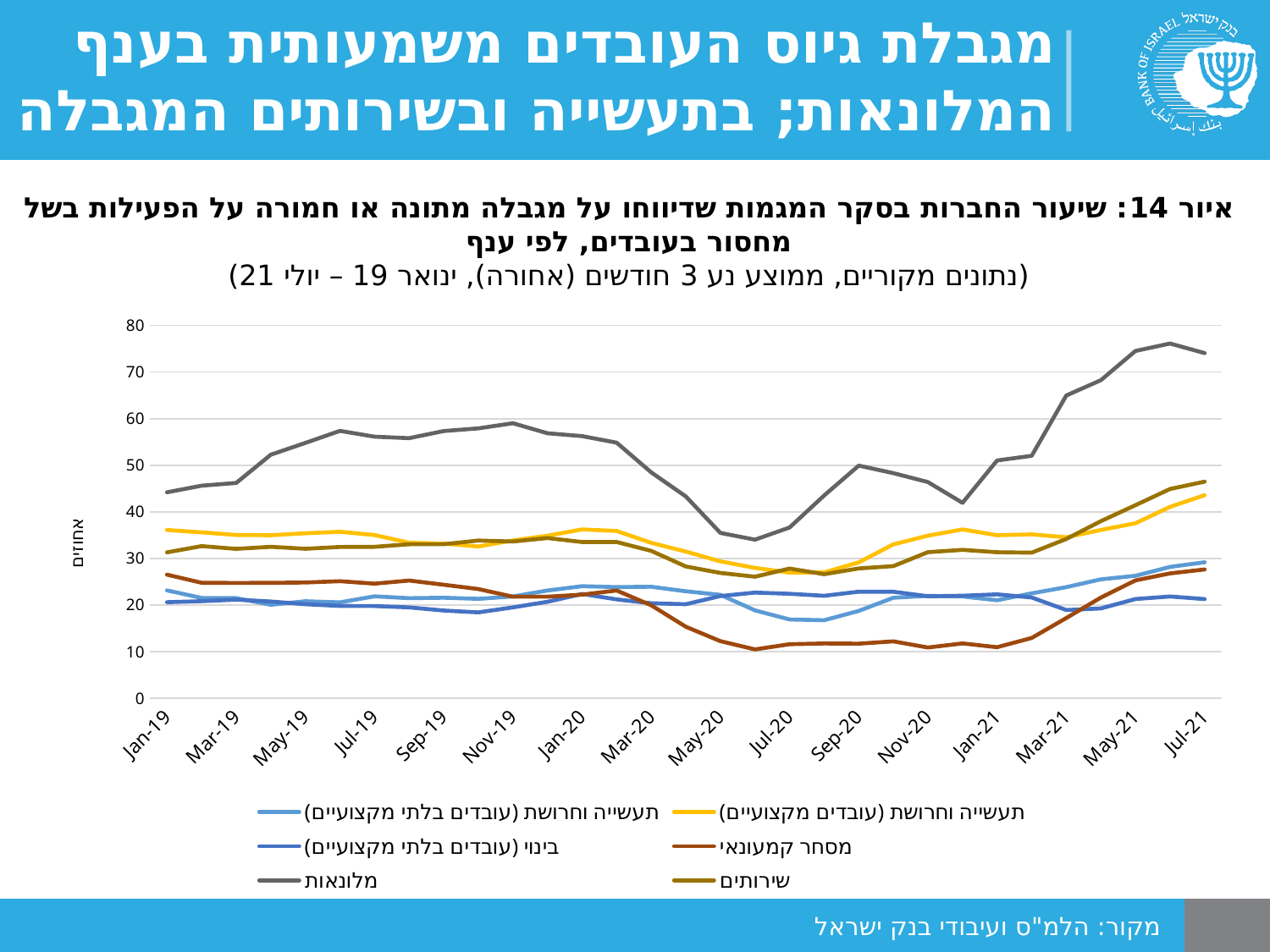
Which series has the lowest value at Jun-20? מסחר קמעונאי What is the label on the vertical axis of the chart? אחוזים What kind of chart is shown on the slide? line chart Is the value for מלונאות at Jun-20 greater or less than 40? less Which series has the highest value at Jan-19? מלונאות Is the value for מלונאות at Jul-21 greater or less than 70? greater Is the value for מסחר קמעונאי at Jan-19 greater or less than 20? greater How many series does the legend list? 6 Which series has the highest value at Jul-21? מלונאות Does the value for מסחר קמעונאי rise or fall between Mar-20 and Jun-20? fall Does the value for מלונאות rise or fall between Mar-21 and Jul-21? rise